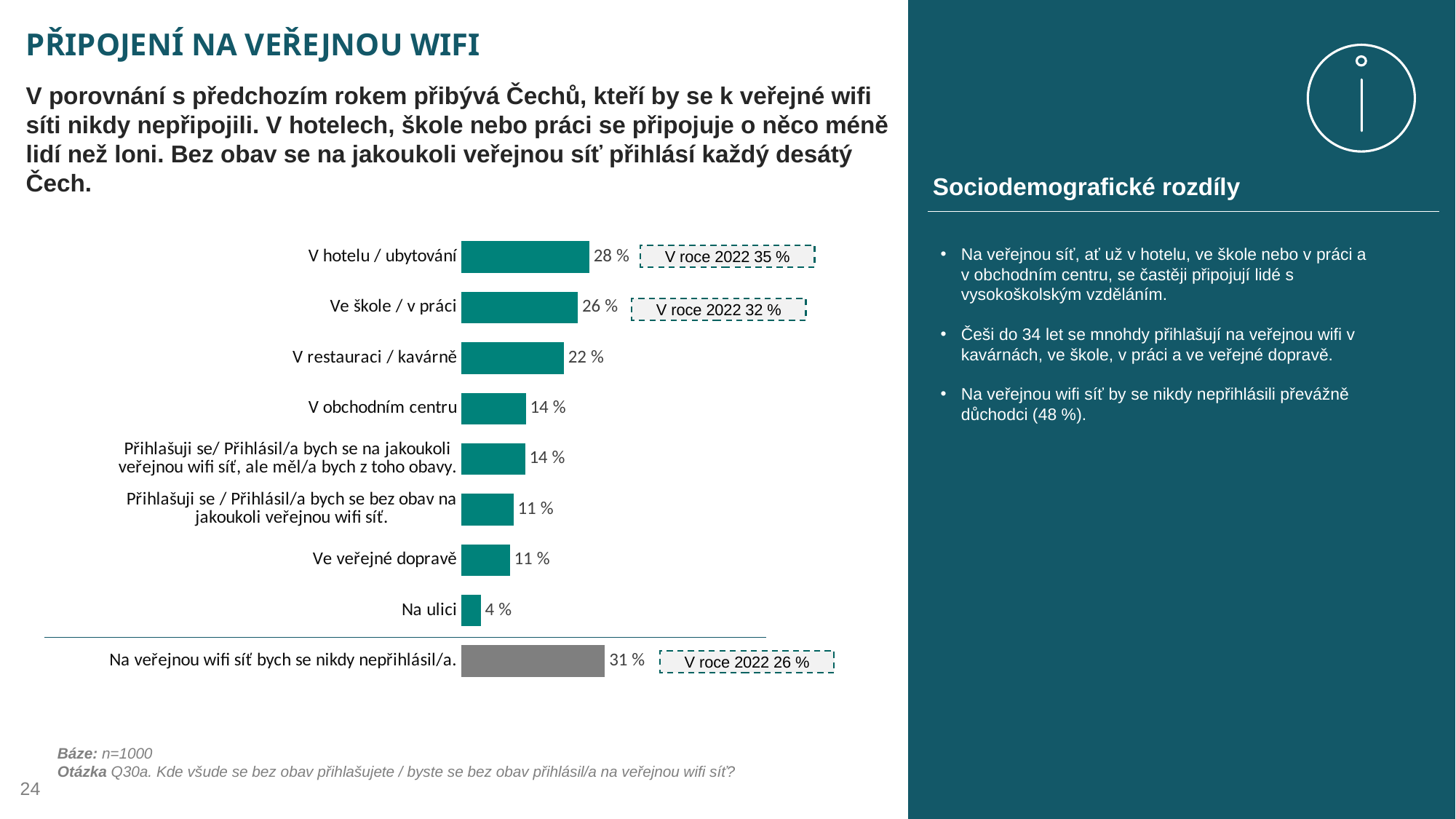
Which category has the highest value? Na veřejnou wifi síť bych se nikdy nepřihlásil/a. What kind of chart is shown on the slide? Bar chart What is the difference between the values for "V hotelu / ubytování" and "Ve škole / v práci"? 2 % According to the annotation, what was the value for "Ve škole / v práci" in 2022? 32 % What is the value for "V hotelu / ubytování"? 28 % What is the difference between the 2022 value and the current value for "Na veřejnou wifi síť bych se nikdy nepřihlásil/a."? 5 % What is the value for "V restauraci / kavárně"? 22 % Which category has the lowest value? Na ulici What is the value for "Ve veřejné dopravě"? 11 % What is the value for "Na veřejnou wifi síť bych se nikdy nepřihlásil/a."? 31 % Which is larger, the value for "V restauraci / kavárně" or the value for "V obchodním centru"? V restauraci / kavárně How many categories are shown in the chart? 9